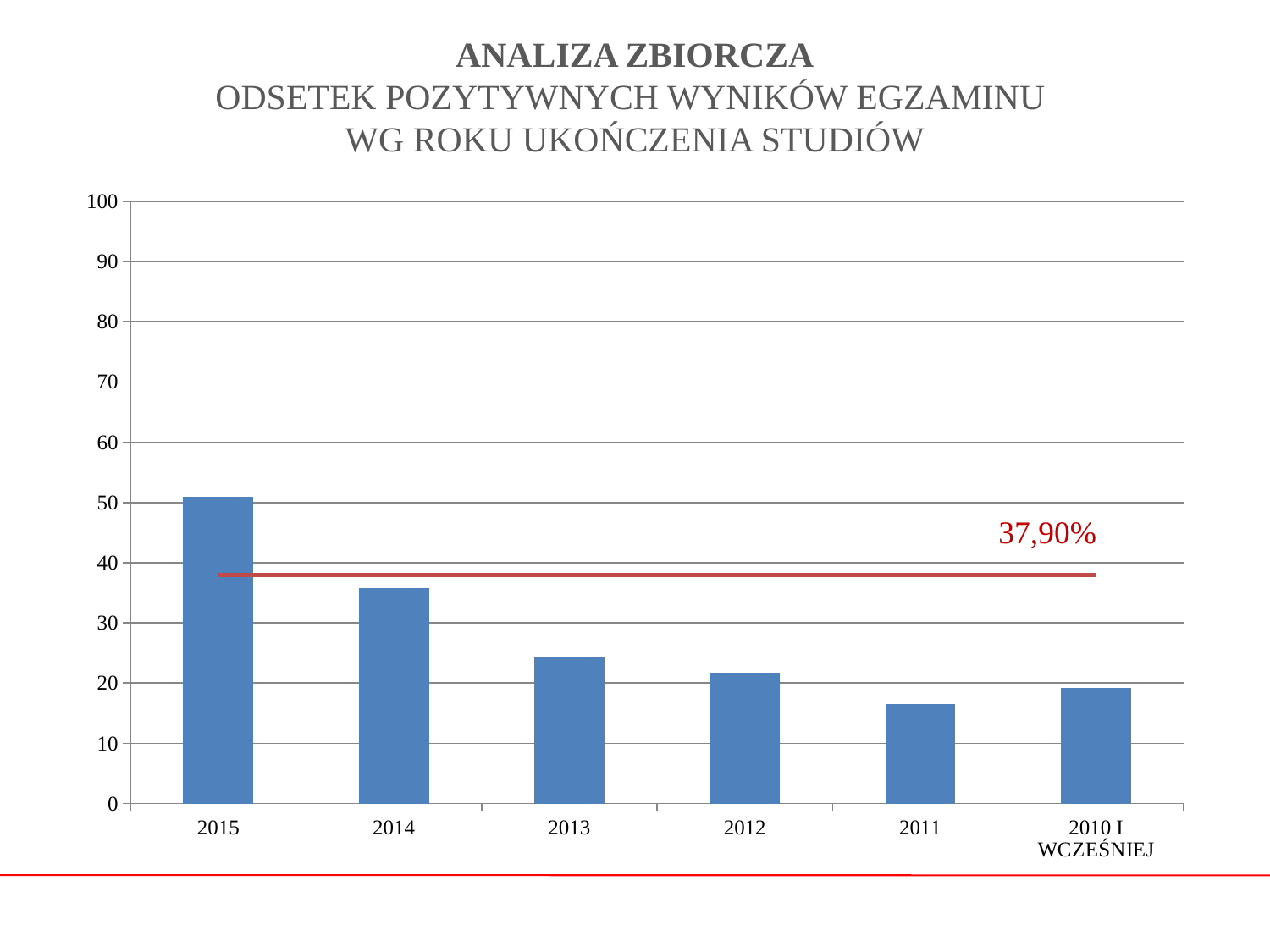
Which has the larger value, 2015 or 2014? 2015 What value is labelled on the red horizontal line in the chart? 37,90% Do the bar values rise or fall from 2015 to 2011 along the x axis? fall Is the value for 2015 greater or less than 40? greater Which category has the lowest bar in the chart? 2011 Is the value for 2011 greater or less than 20? less Which has the larger value, 2012 or 2011? 2012 Which category has the highest bar in the chart? 2015 Is the value for 2014 greater or less than 40? less What kind of chart is shown on the slide? bar chart How many categories are shown on the x axis of the chart? 6